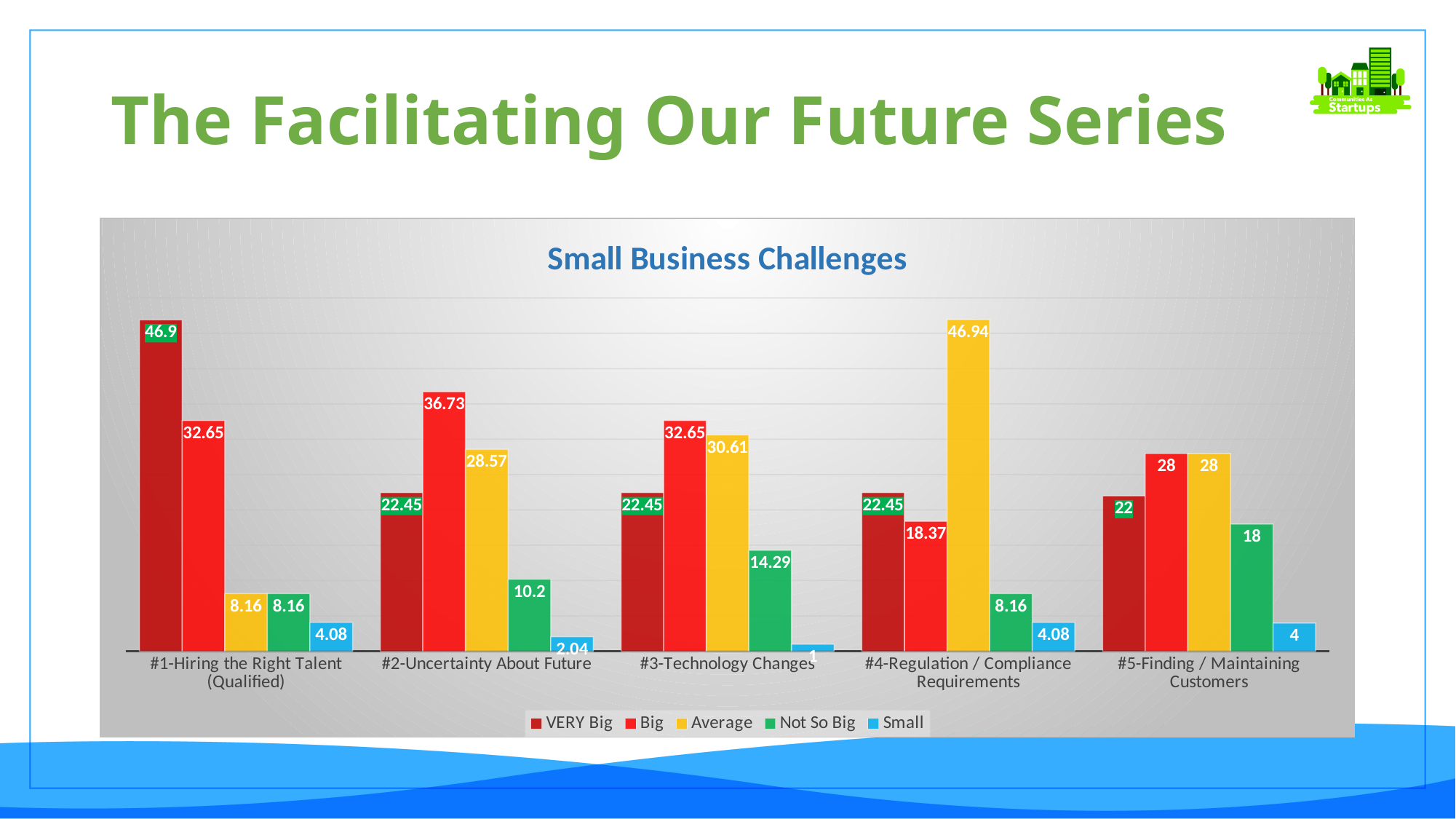
What is the Big value for #2-Uncertainty About Future? 36.73 What type of chart is shown on the slide? bar chart What is the VERY Big value for #1-Hiring the Right Talent (Qualified)? 46.9 Which category has the highest VERY Big value? #1-Hiring the Right Talent (Qualified) What is the Average value for #4-Regulation / Compliance Requirements? 46.94 What is the title of the chart? Small Business Challenges What is the Not So Big value for #3-Technology Changes? 14.29 How many categories are shown on the x axis? 5 Which category has the lowest Small value? #3-Technology Changes What is the difference between the Big and Average values for #3-Technology Changes? 2.04 For #4-Regulation / Compliance Requirements, which is larger: the VERY Big value or the Big value? VERY Big How many series does the legend list? 5